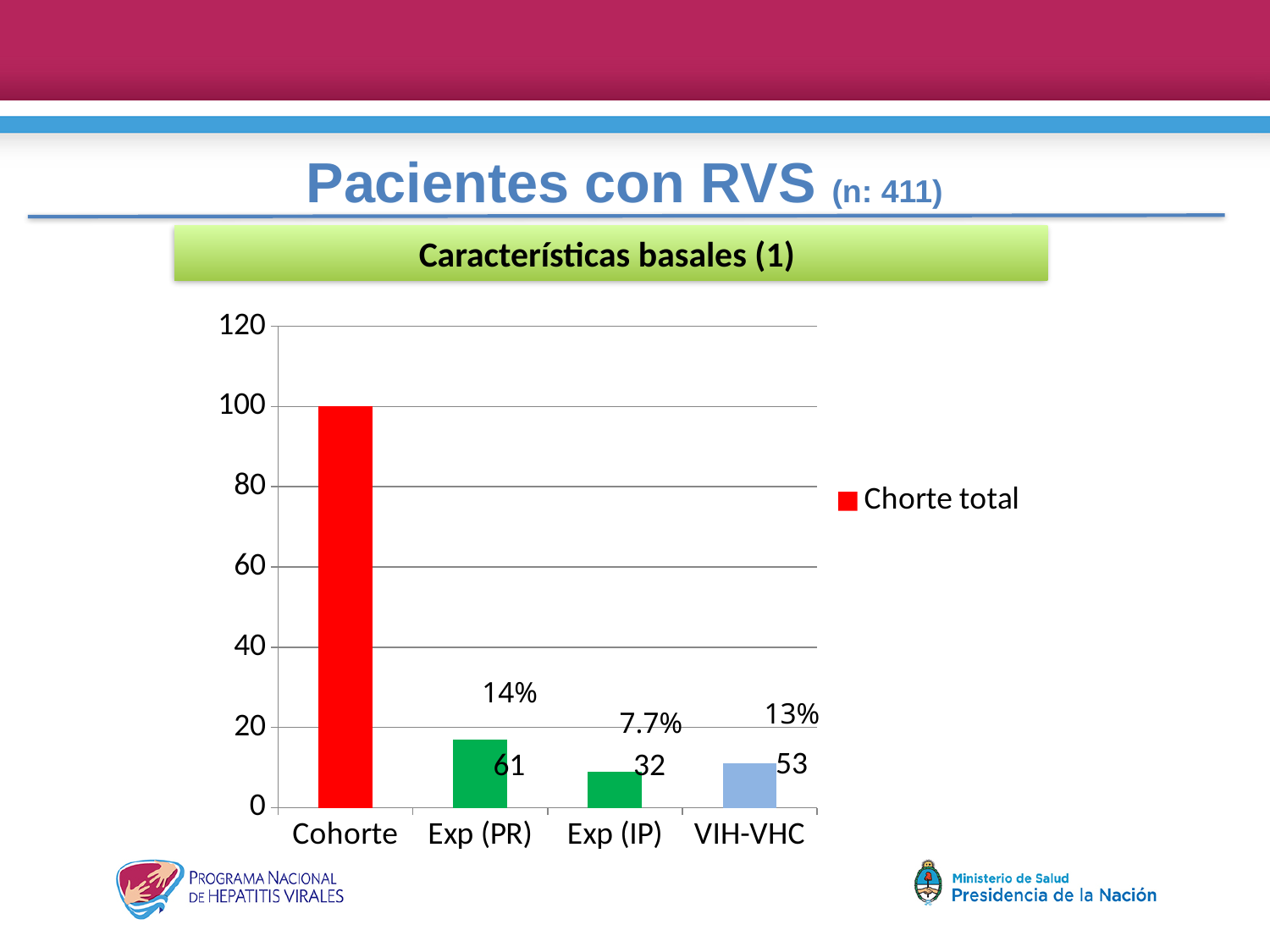
What is the legend entry shown for the chart? Chorte total Which category has the shortest bar in the chart? Exp (IP) What percentage label is shown above the VIH-VHC bar? 13% How many series does the chart legend list? 1 What is the difference between the numbers printed next to the Exp (PR) bar (61) and the Exp (IP) bar (32)? 29 Which category has the tallest bar in the chart? Cohorte What kind of chart is shown on the slide? bar chart What percentage label is shown above the Exp (IP) bar? 7.7% How many categories are shown on the x axis of the chart? 4 What number is printed next to the VIH-VHC bar? 53 What percentage label is shown above the Exp (PR) bar? 14% Is the value for Cohorte greater or less than 80? greater